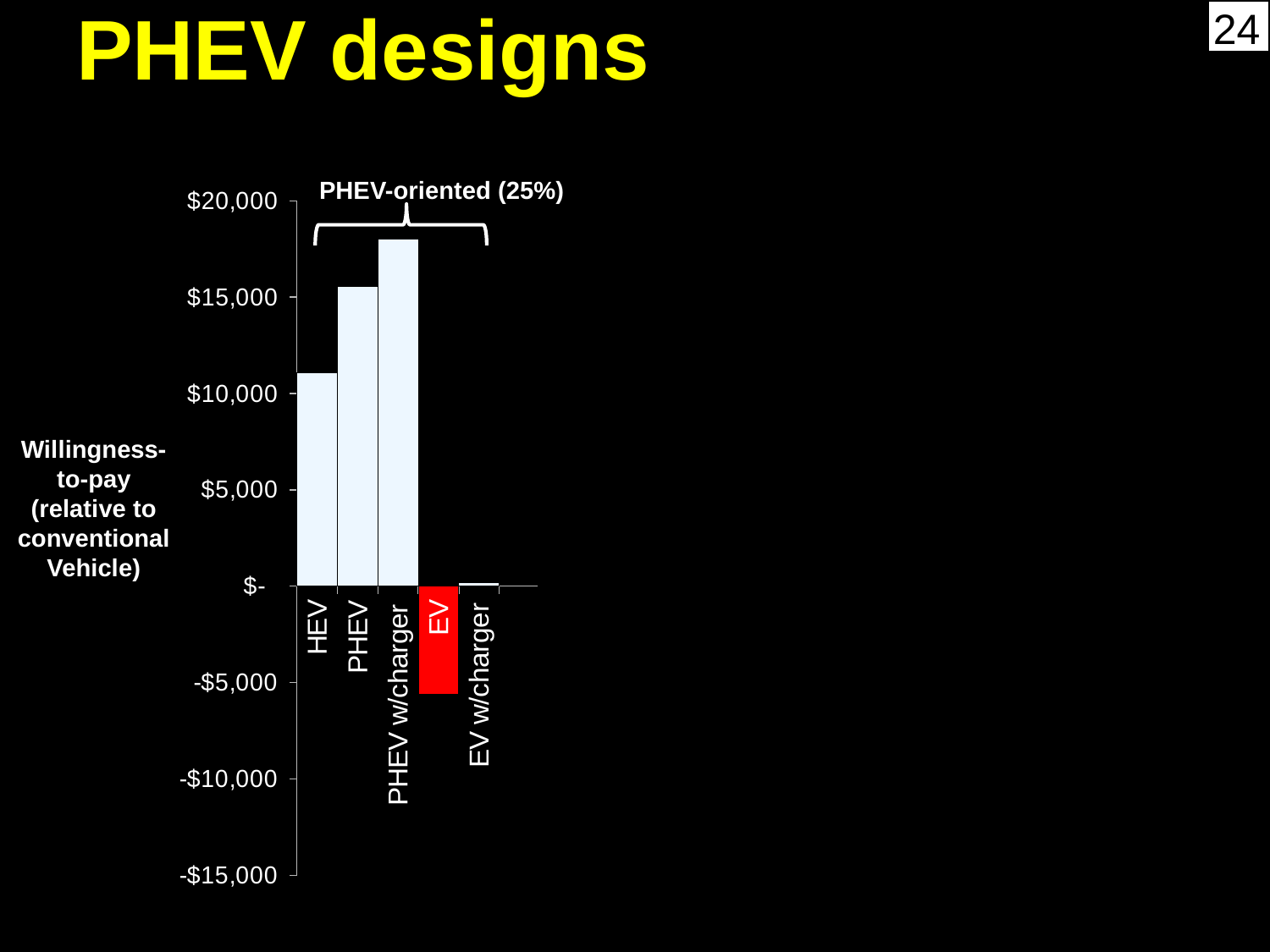
Which has a larger willingness-to-pay, EV or EV w/charger? EV w/charger Is the value for PHEV w/charger greater or less than $15,000? greater What is the label on the vertical axis of the chart? Willingness-to-pay (relative to conventional Vehicle) Is the value for EV greater or less than $0? less Which has a larger willingness-to-pay, HEV or PHEV? PHEV Which category has the lowest willingness-to-pay? EV Is the value for HEV greater or less than $10,000? greater What label appears above the bracket grouping the first three bars? PHEV-oriented (25%) What kind of chart is shown on the slide? bar chart How many categories are plotted on the chart? 5 Which category has the highest willingness-to-pay? PHEV w/charger